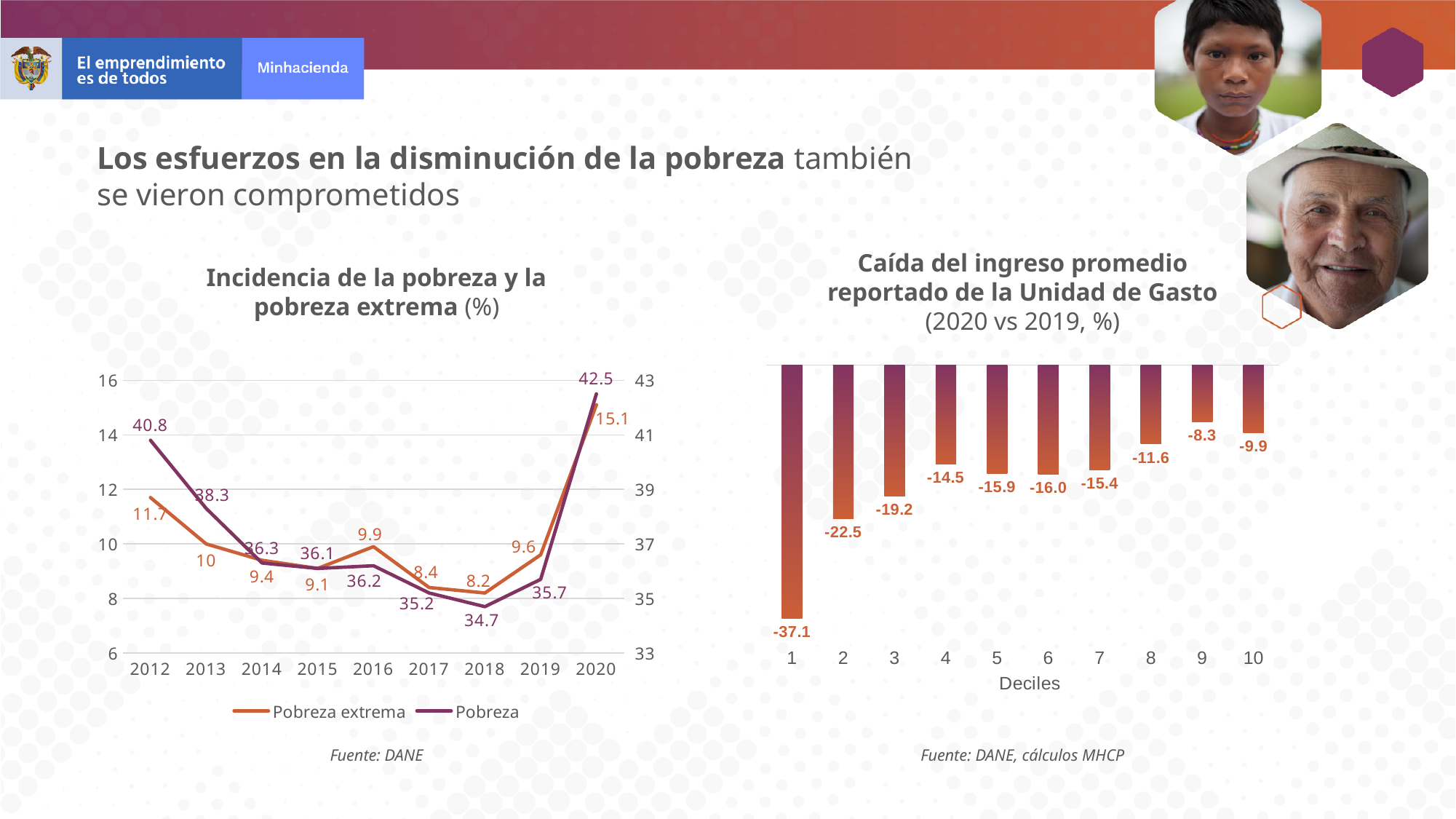
In the chart 'Incidencia de la pobreza y la pobreza extrema', what kind of chart is it? Line chart In the chart 'Incidencia de la pobreza y la pobreza extrema', what is the value of Pobreza in 2012? 40.8 In the chart 'Caída del ingreso promedio reportado de la Unidad de Gasto', which decile has the smallest fall in income? 9 In the chart 'Incidencia de la pobreza y la pobreza extrema', in which year is the Pobreza extrema series highest? 2020 In the chart 'Caída del ingreso promedio reportado de la Unidad de Gasto', what is the value for decile 1? -37.1 In the chart 'Caída del ingreso promedio reportado de la Unidad de Gasto', what is the difference between the values for decile 1 and decile 2? 14.6 In the chart 'Incidencia de la pobreza y la pobreza extrema', by how much did Pobreza increase from 2019 to 2020? 6.8 In the chart 'Caída del ingreso promedio reportado de la Unidad de Gasto', how many deciles are shown? 10 In the chart 'Incidencia de la pobreza y la pobreza extrema', how many series does the legend list? 2 In the chart 'Incidencia de la pobreza y la pobreza extrema', what is the value of Pobreza extrema in 2020? 15.1 In the chart 'Caída del ingreso promedio reportado de la Unidad de Gasto', what kind of chart is it? Bar chart In the chart 'Incidencia de la pobreza y la pobreza extrema', in which year is the Pobreza series lowest? 2018